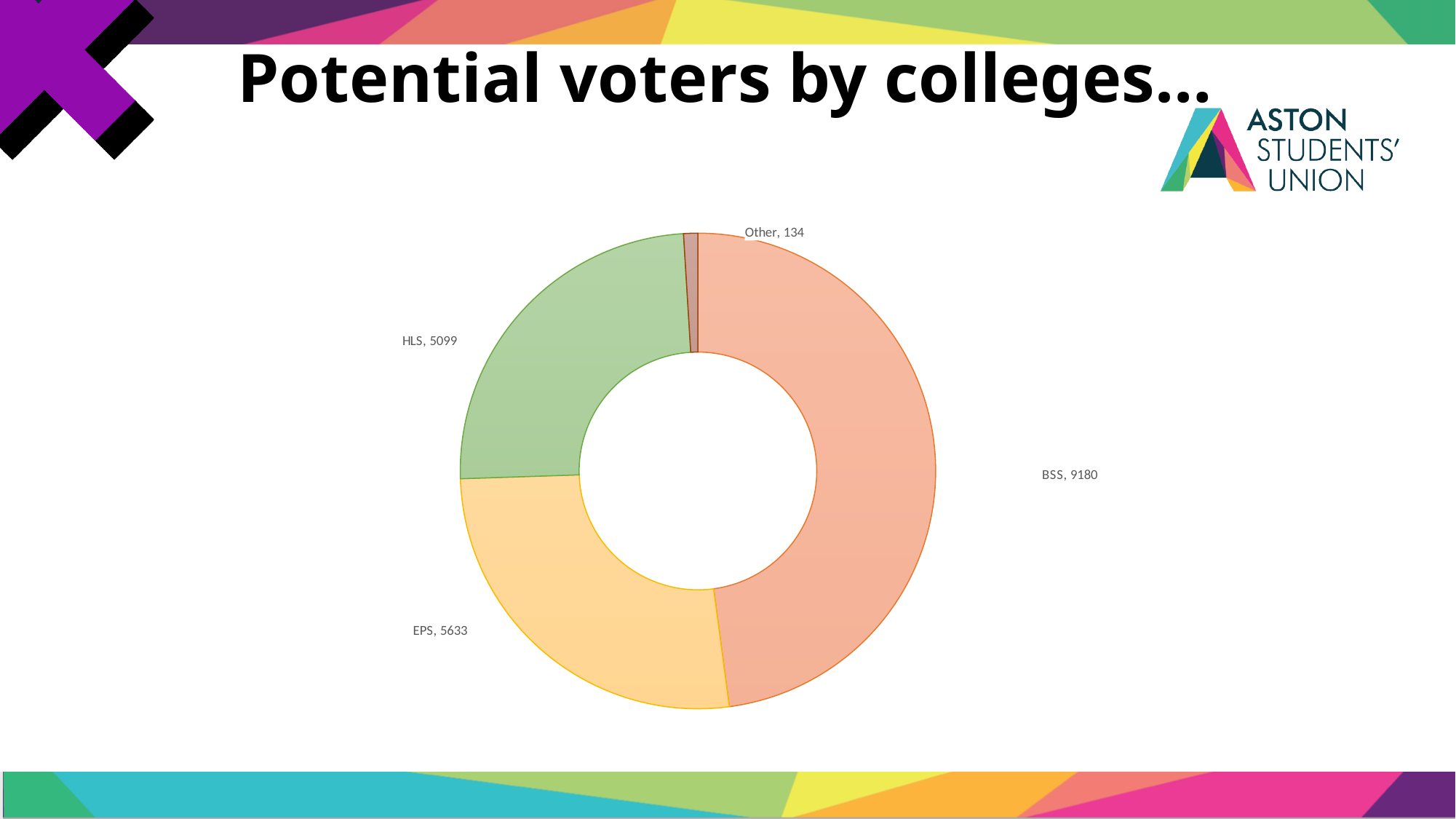
What is the difference between the values for BSS and EPS? 3547 Which is larger, the value for EPS or the value for HLS? EPS How many categories are shown in the chart? 4 What is the value for HLS? 5099 What is the title of the slide containing the chart? Potential voters by colleges... Which college has the largest number of potential voters? BSS What kind of chart is shown on the slide? Doughnut (pie) chart What is the value for BSS? 9180 What is the difference between the values for EPS and HLS? 534 Which category has the smallest number of potential voters? Other What is the value for EPS? 5633 What is the value for Other? 134